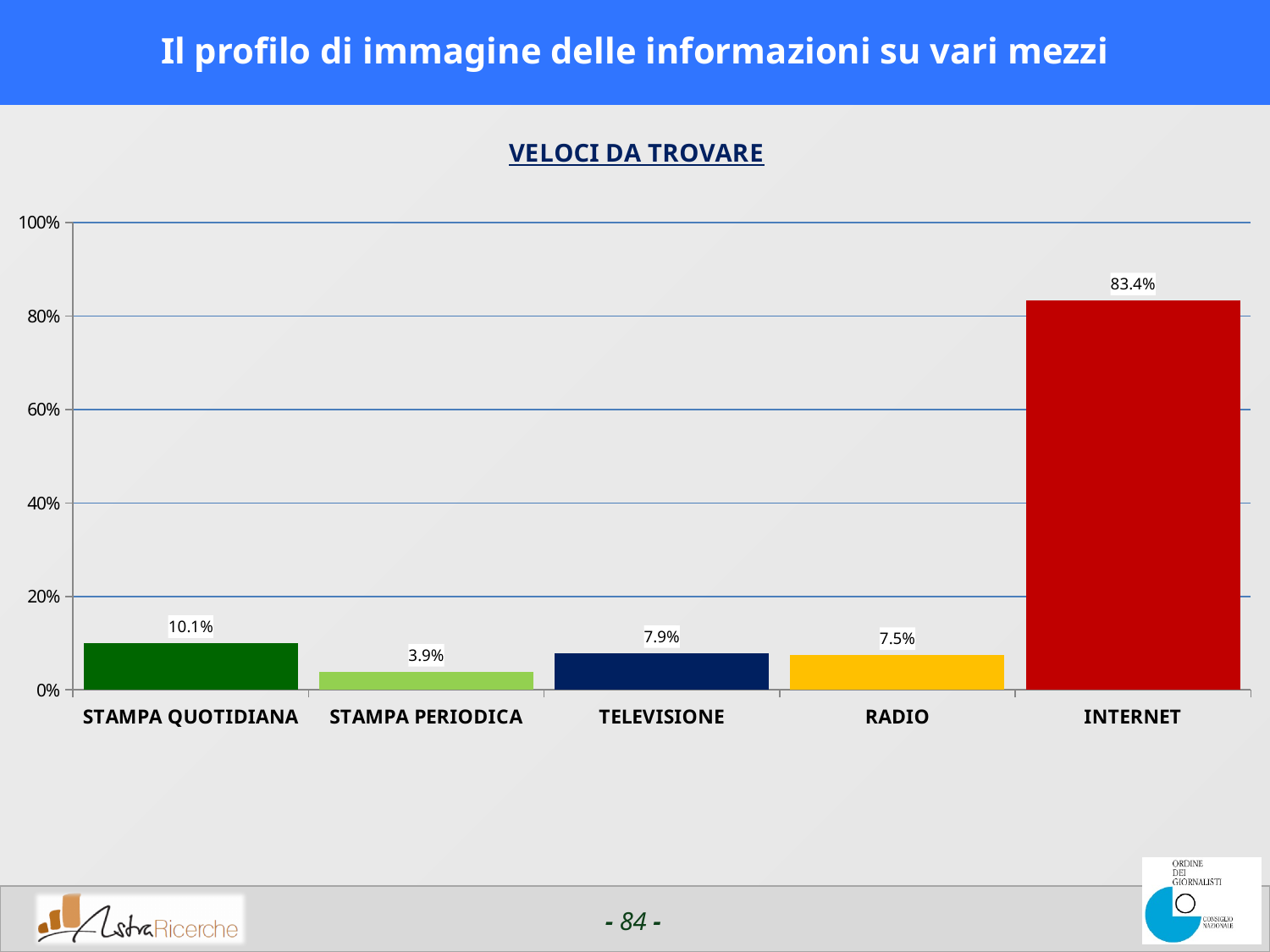
What is the value for RADIO? 7.5% Is the value for INTERNET greater or less than 80%? greater What kind of chart is shown on the slide? bar chart What is the value for STAMPA PERIODICA? 3.9% Which is larger, the value for TELEVISIONE or the value for STAMPA PERIODICA? TELEVISIONE Which category has the lowest value? STAMPA PERIODICA Which category has the highest value? INTERNET What is the value for INTERNET? 83.4% What is the title of the chart? VELOCI DA TROVARE What is the value for STAMPA QUOTIDIANA? 10.1% How many categories are shown on the x axis? 5 What is the difference between the values for INTERNET and STAMPA QUOTIDIANA? 73.3%